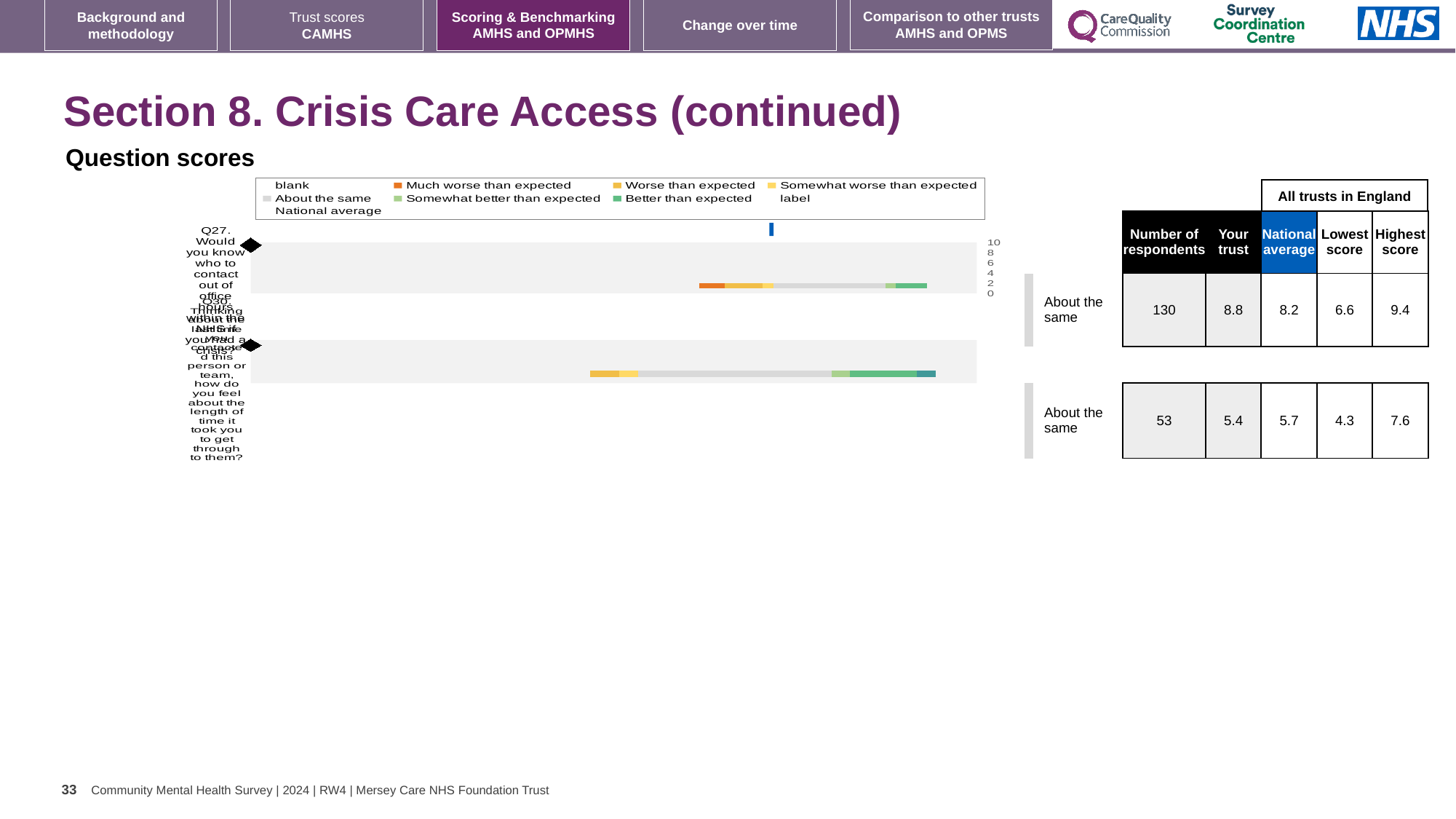
How many entries does the legend of the 'Question scores' chart list? 9 For Q27, which is larger: the 'Your trust' score or the national average? Your trust What is the highest tick value shown on the score axis of the 'Question scores' chart? 10 How many respondents answered Q27 according to the table beside the chart? 130 In the table beside the chart, what is the 'Your trust' score for Q27 (knowing who to contact out of office hours)? 8.8 Which question has the higher 'Your trust' score, Q27 or Q30? Q27 How many questions (bars) are plotted in the 'Question scores' chart? 2 What is the difference between the highest score (9.4) and the lowest score (6.6) for Q27? 2.8 What kind of chart is shown under 'Question scores'? bar chart For Q30, which is larger: the 'Your trust' score or the national average? National average In the table beside the chart, what is the national average score for Q30 (length of time to get through to the crisis contact)? 5.7 What benchmark category is shown next to both Q27 and Q30 in the chart? About the same